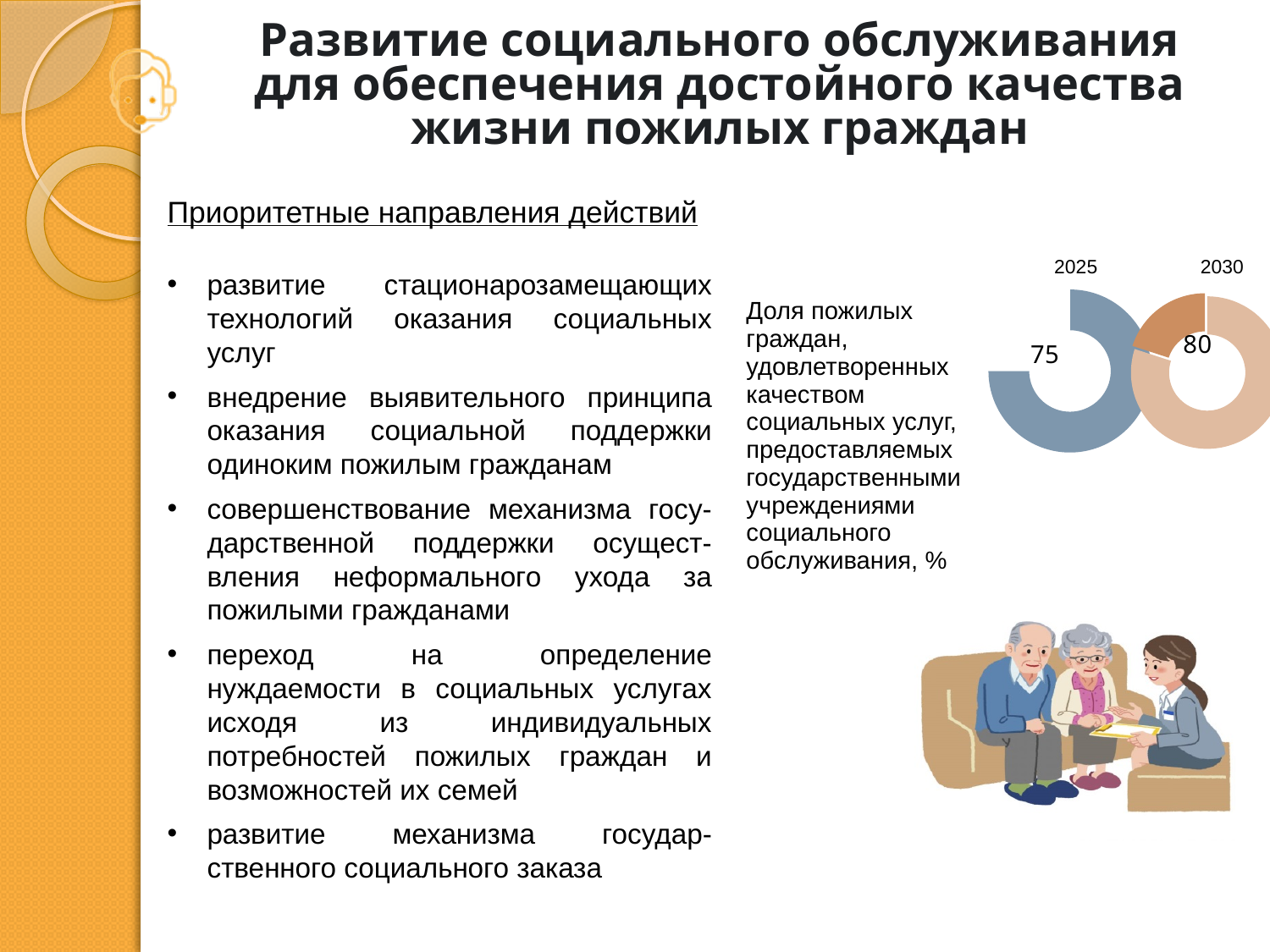
What is the value shown in the 2025 donut chart? 75 Which year's donut chart is drawn in blue-grey? 2025 Which year shows the higher share of satisfied elderly citizens, 2025 or 2030? 2030 Which year shows the lower value in the donut charts? 2025 In what unit are the donut chart values expressed, according to the chart description? % What kind of chart is used to show the share of satisfied elderly citizens? Donut (pie) chart What is the value shown in the 2030 donut chart? 80 By how much does the value for 2030 exceed the value for 2025? 5 How many years are shown in the donut charts? 2 Does the share of satisfied elderly citizens rise or fall from 2025 to 2030? Rises